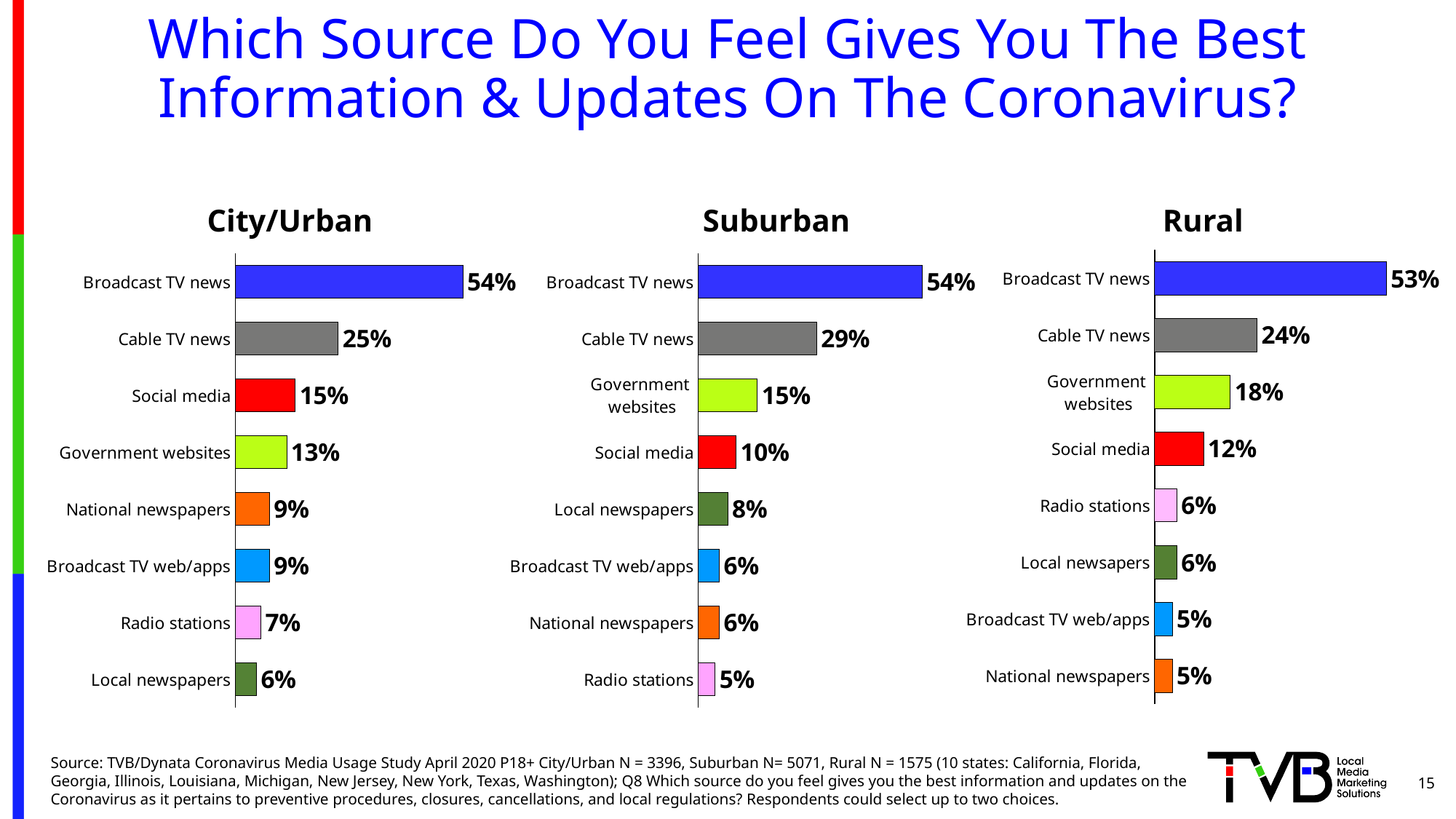
In the Suburban chart, what is the difference between Broadcast TV news and Cable TV news? 25% In the City/Urban chart, which is larger: Social media or Government websites? Social media How many sources are listed in the Suburban chart? 8 What is the title of the rightmost chart on the slide? Rural In the Rural chart, what is the difference between Government websites and Social media? 6% In the Rural chart, what percentage is shown for Social media? 12% In the City/Urban chart, which source has the lowest percentage? Local newspapers In the Rural chart, which source has the highest percentage? Broadcast TV news What type of chart is used for the City/Urban data? Bar chart In the City/Urban chart, what percentage is shown for Cable TV news? 25% In the Suburban chart, what percentage is shown for Government websites? 15% In the Suburban chart, what percentage is shown for Radio stations? 5%